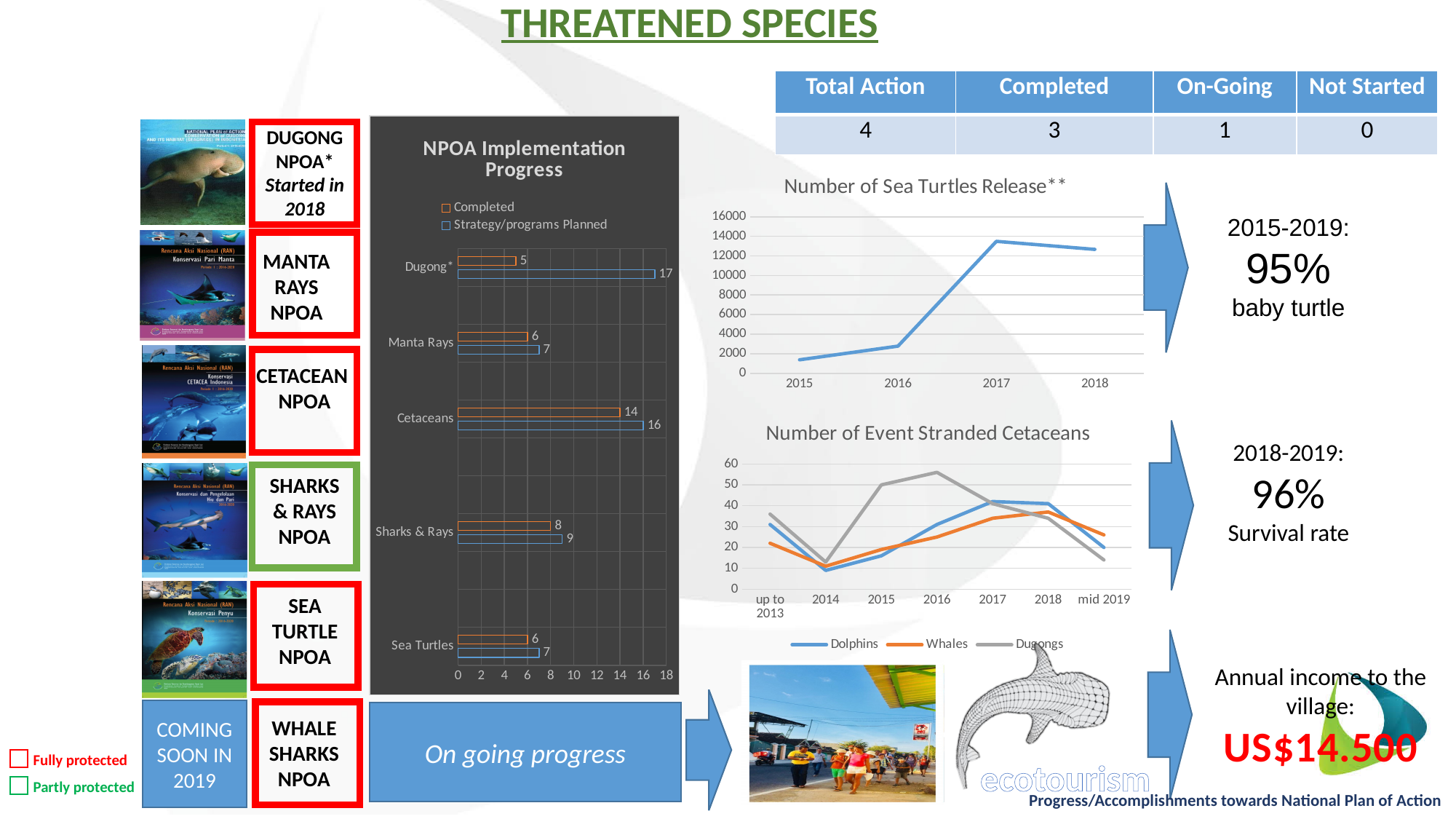
In the Number of Event Stranded Cetaceans chart, is the Dugongs value for 2016 greater or less than 50? greater In the NPOA Implementation Progress chart, how many categories are shown? 5 In the NPOA Implementation Progress chart, which category has the lowest Completed value? Dugong* In the NPOA Implementation Progress chart, what is the Completed value for Cetaceans? 14 In the NPOA Implementation Progress chart, what is the Strategy/programs Planned value for Dugong*? 17 How many series does the legend of the Number of Event Stranded Cetaceans chart list? 3 What type of chart is the NPOA Implementation Progress chart? bar chart In the Number of Sea Turtles Release chart, do the values rise or fall from 2015 to 2017? rise In the Number of Sea Turtles Release chart, is the value for 2017 greater or less than 12000? greater In the NPOA Implementation Progress chart, which category has the highest Completed value? Cetaceans In the NPOA Implementation Progress chart, what is the difference between the Strategy/programs Planned and Completed values for Dugong*? 12 In the Number of Sea Turtles Release chart, is the value for 2015 greater or less than 2000? less